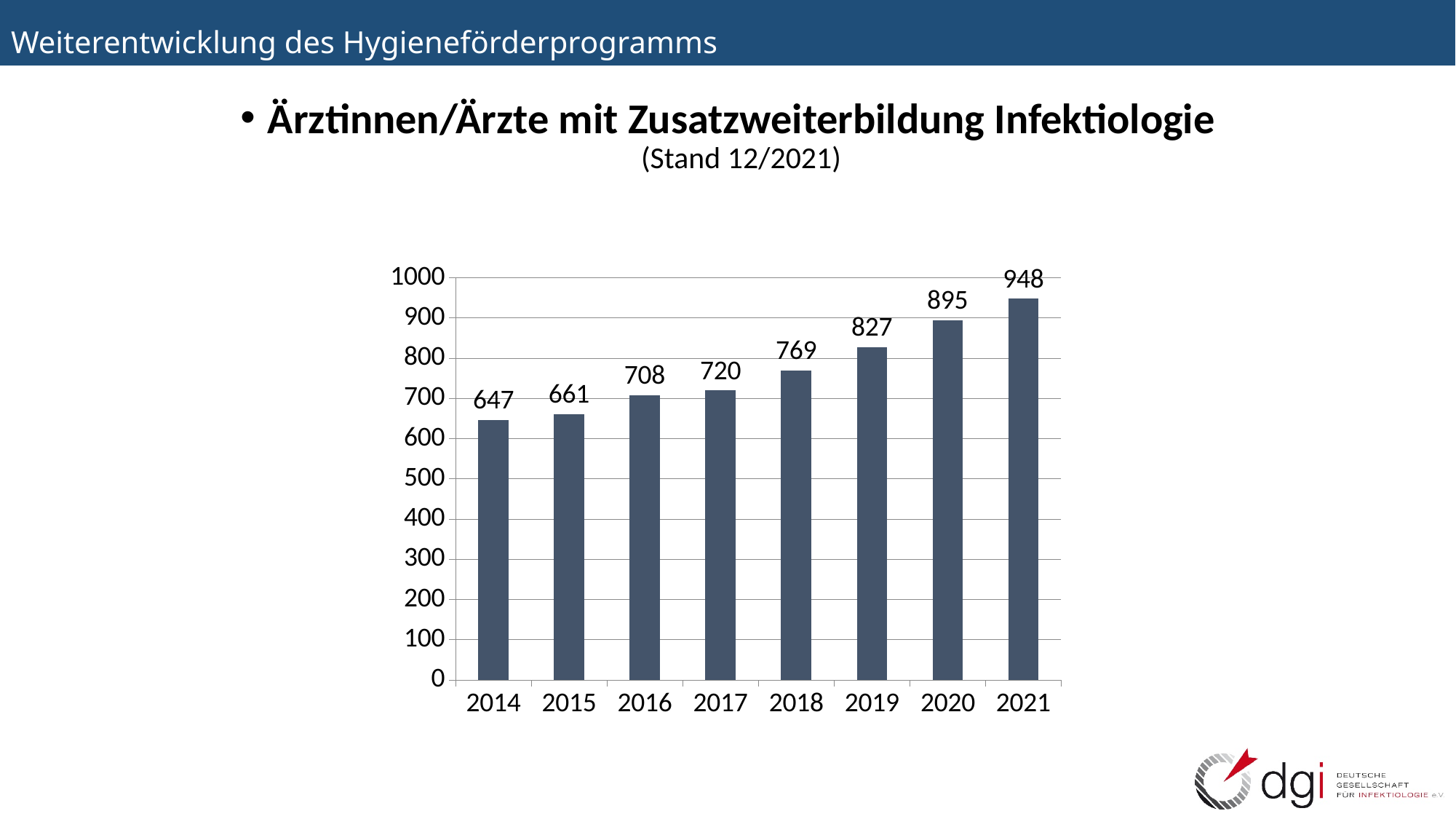
Which year has the lowest value? 2014 What is the difference between the values for 2021 and 2014? 301 What kind of chart is shown on the slide? bar chart What is the value for 2014? 647 What is the value for 2018? 769 What is the difference between the values for 2020 and 2019? 68 What is the value for 2021? 948 Which is larger, the value for 2016 or the value for 2017? 2017 How many years are shown on the x axis? 8 Which year has the highest value? 2021 Do the values rise or fall from 2014 to 2021? rise Is the value for 2019 greater or less than 800? greater